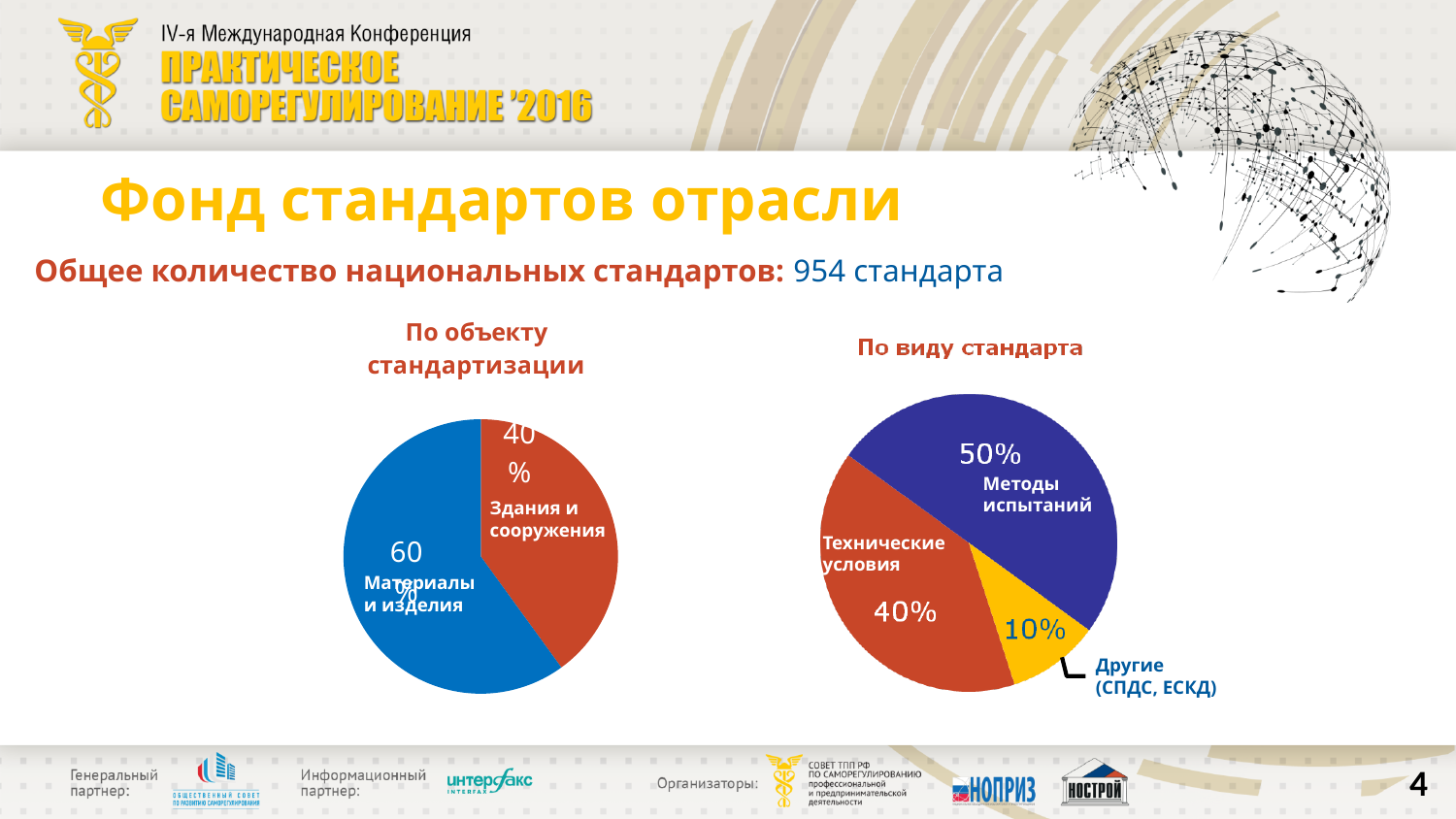
In the chart titled "По виду стандарта", what share does "Методы испытаний" have? 50% What type of chart is the chart titled "По виду стандарта"? Pie chart In the chart titled "По виду стандарта", how many categories are shown? 3 In the chart titled "По объекту стандартизации", how many slices does the pie have? 2 In the chart titled "По объекту стандартизации", which category has the largest share? Материалы и изделия In the chart titled "По объекту стандартизации", what share does "Материалы и изделия" have? 60% In the chart titled "По виду стандарта", which is larger: "Методы испытаний" or "Технические условия"? Методы испытаний In the chart titled "По виду стандарта", what share does "Технические условия" have? 40% In the chart titled "По объекту стандартизации", what share does "Здания и сооружения" have? 40% In the chart titled "По объекту стандартизации", what is the difference in percentage points between "Материалы и изделия" and "Здания и сооружения"? 20 In the chart titled "По виду стандарта", which category has the smallest share? Другие (СПДС, ЕСКД) In the chart titled "По виду стандарта", what share does "Другие (СПДС, ЕСКД)" have? 10%